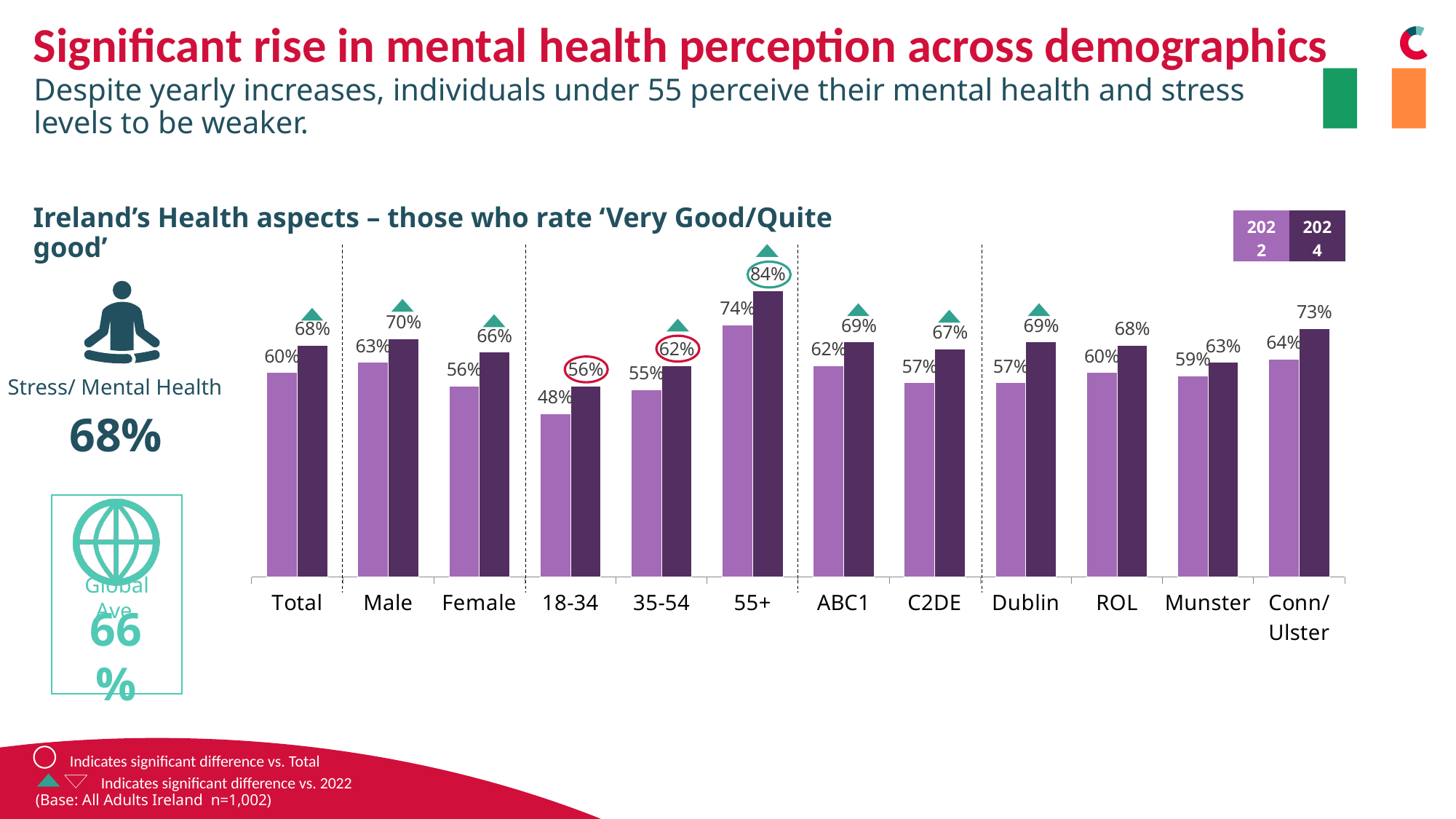
What is the 2024 value for the 55+ age group? 84% What is the difference between the 2024 and 2022 values for Dublin? 12 percentage points What is the difference between the 2024 values for 55+ and 18-34? 28 percentage points Which category has the highest 2024 value? 55+ How many categories are shown on the x axis? 12 What is the 2024 value for Conn/Ulster? 73% What is the title of the chart? Ireland's Health aspects – those who rate 'Very Good/Quite good' What kind of chart is shown on the slide? Bar chart Which is larger, the 2024 value for Male or the 2024 value for Female? Male Which category has the lowest 2022 value? 18-34 How many series does the legend list? 2 What is the 2022 value for the 18-34 age group? 48%